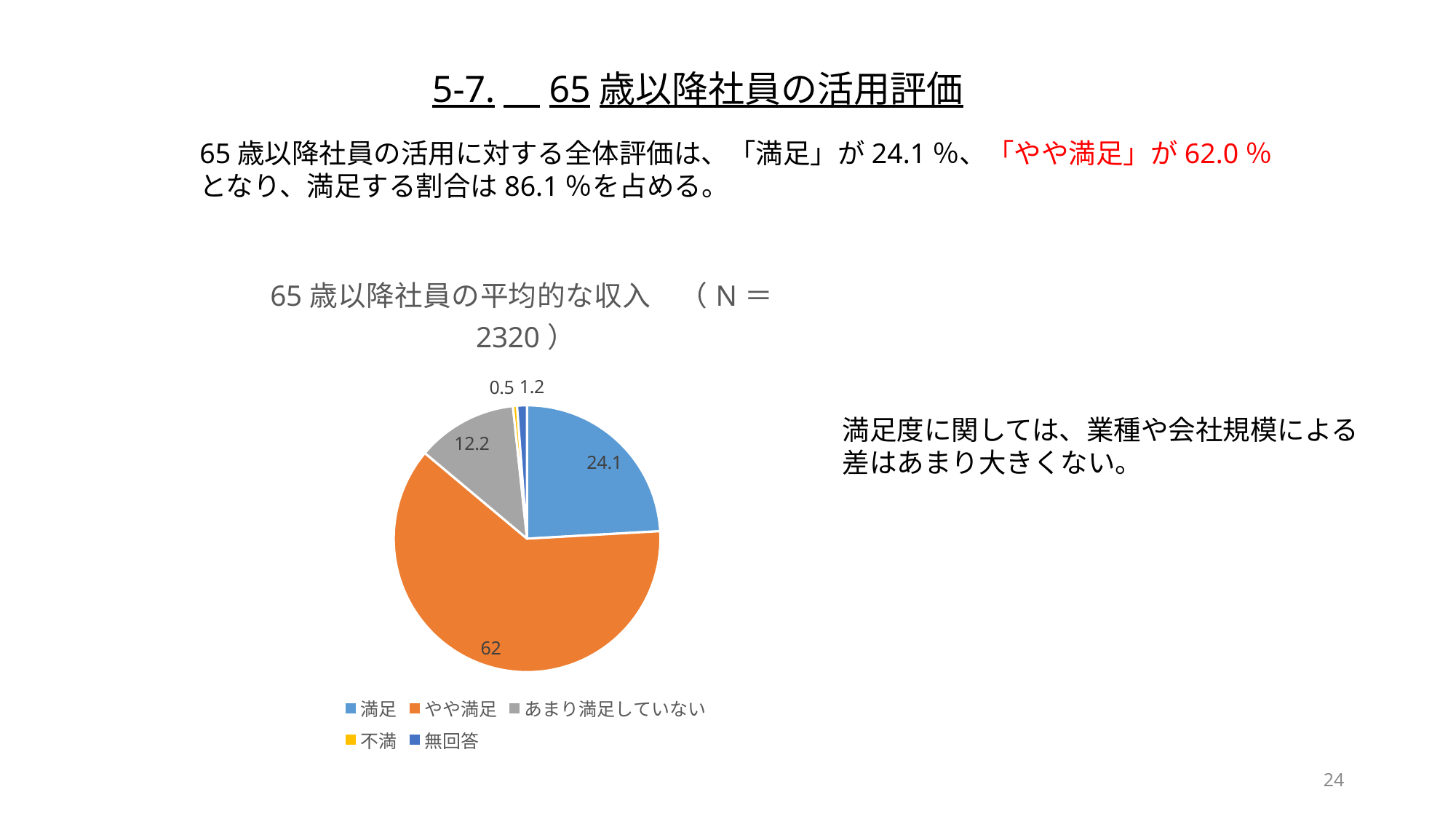
What is the N value shown in the chart title? 2320 What kind of chart is shown on the slide? Pie chart What is the value shown for the やや満足 slice? 62 What colour is the やや満足 slice in the pie chart? Orange What is the value shown for the 満足 slice? 24.1 How many categories does the legend of the pie chart list? 5 What is the difference between the values for やや満足 and 満足? 37.9 Which is larger, the value for 満足 or the value for あまり満足していない? 満足 What is the value shown for the あまり満足していない slice? 12.2 Which category has the smallest slice of the pie? 不満 What is the value shown for the 無回答 slice? 1.2 Which category has the largest slice of the pie? やや満足